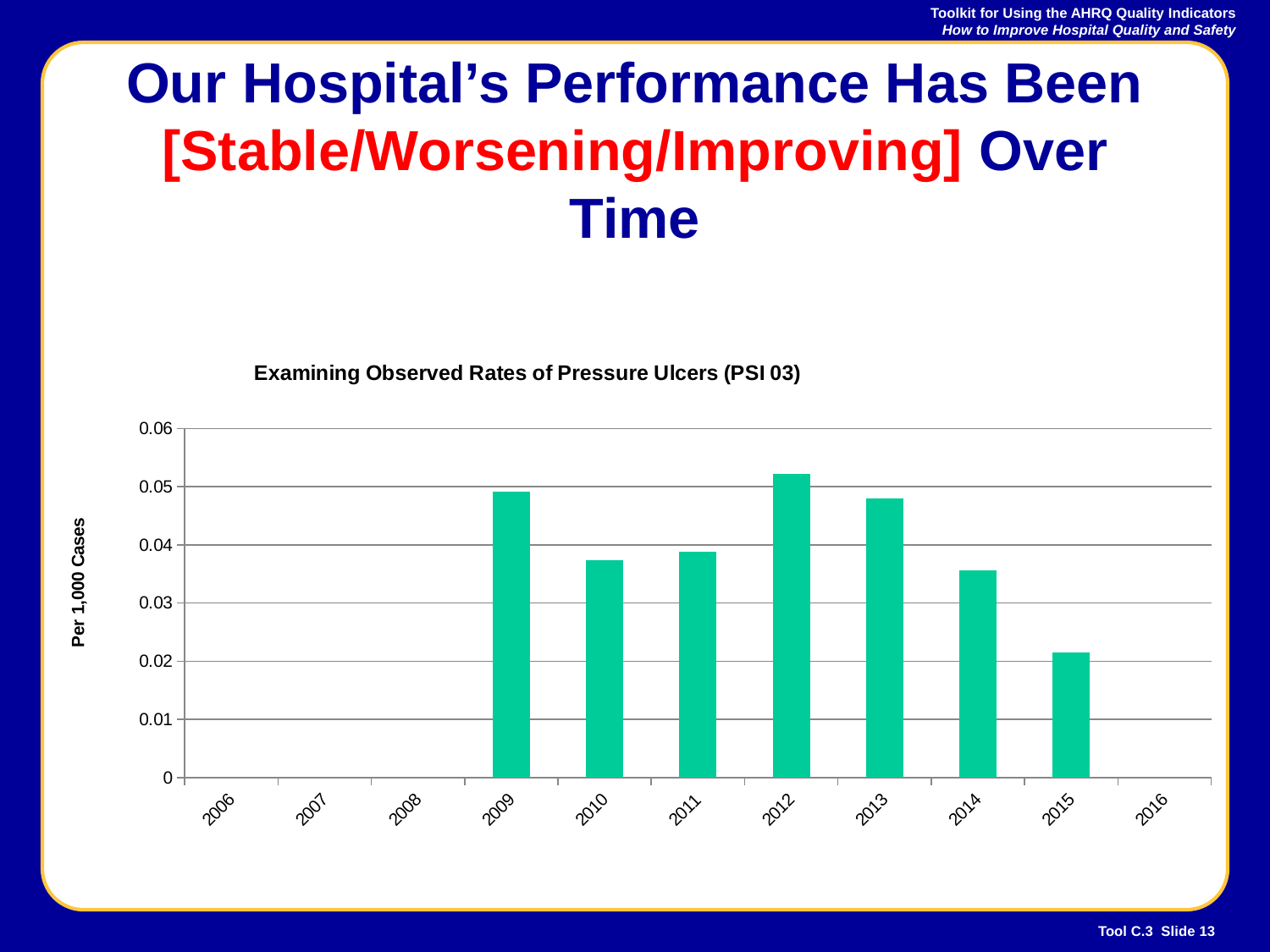
Is the value for 2009 greater or less than 0.04? greater Among the years with a bar shown, which year has the lowest observed rate? 2015 What kind of chart is shown on the slide? bar chart Is the value for 2012 greater or less than 0.05? greater What is the title of the chart? Examining Observed Rates of Pressure Ulcers (PSI 03) What is the label on the vertical axis of the chart? Per 1,000 Cases Which year has the highest observed rate of pressure ulcers? 2012 How many years have a bar plotted on the chart? 7 Is the value for 2015 greater or less than 0.03? less Do the values rise or fall from 2012 to 2015? fall Which year has the larger value, 2012 or 2015? 2012